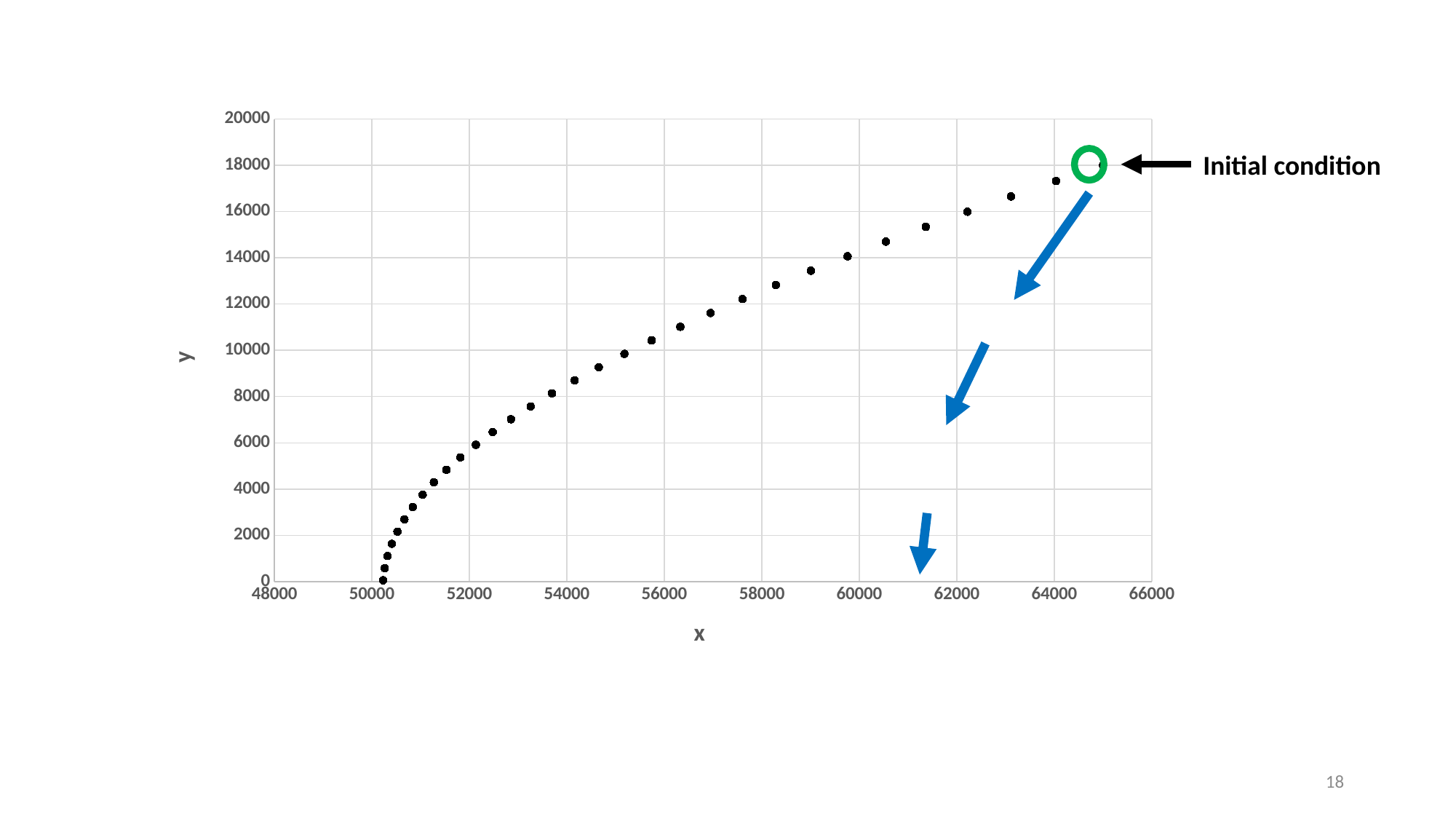
Is the x value of the point marked 'Initial condition' greater or less than 64000? greater Which has the larger y value: the point marked 'Initial condition' or the point nearest x = 56000? the point marked 'Initial condition' What is the label on the horizontal axis of the chart? x What is the label on the vertical axis of the chart? y Is the y value of the plotted point nearest x = 60000 greater or less than 12000? greater Is the y value of the lowest plotted point greater or less than 2000? less As x increases along the horizontal axis, do the plotted y values rise or fall? rise What kind of chart is shown on the slide? scatter plot What is the maximum value shown on the vertical axis of the chart? 20000